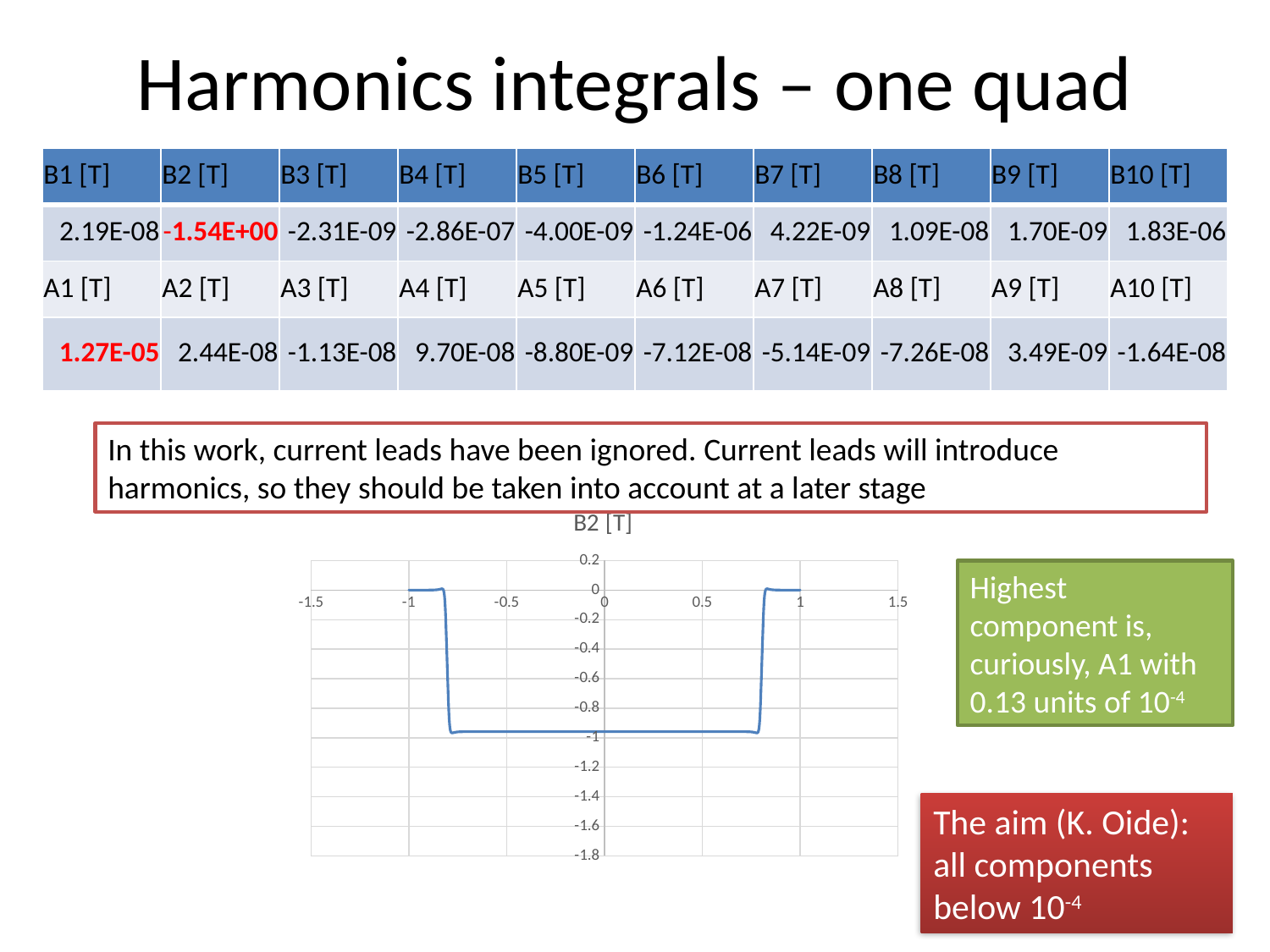
Does the plotted line rise or fall as x goes from 0.8 to 1? rise Is the value of the plotted line at x = 0.5 greater or less than -0.6? less Is the value of the plotted line at x = 0 greater or less than -0.8? less Does the plotted line rise or fall as x goes from -1 to -0.8? fall What is the lowest tick value shown on the y axis of the chart? -1.8 Is the value of the plotted line at x = -1 greater or less than -0.2? greater How many data series are plotted in the chart? 1 Is the plotted line at x = -0.5 higher or lower than at x = -1? lower What kind of chart is shown on the slide? line chart What is the title of the chart on the slide? B2 [T]